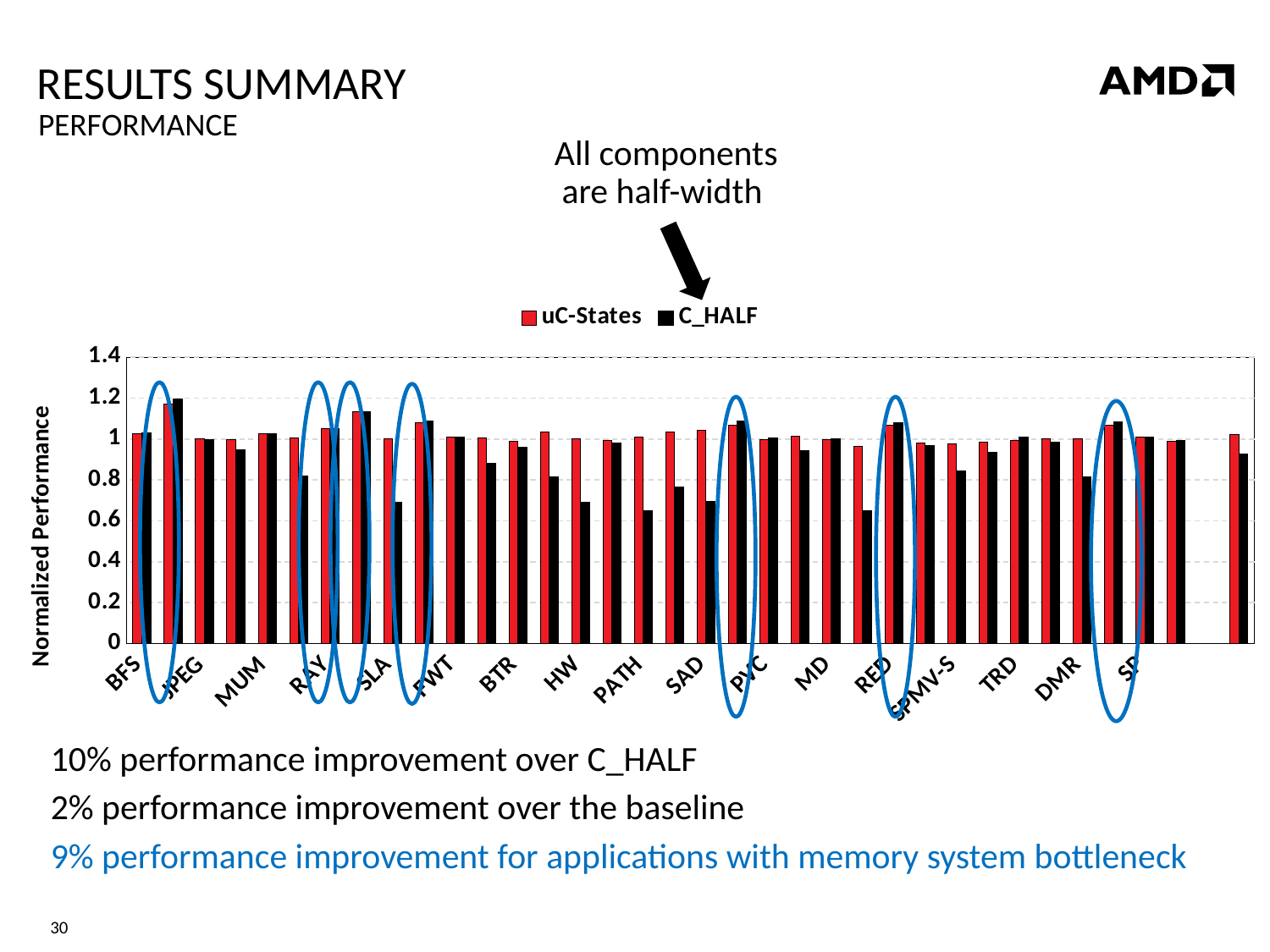
What are the two series named in the chart legend? uC-States and C_HALF How many series does the chart legend list? 2 Is the C_HALF value for SAD greater or less than 0.8? less Which colour represents the C_HALF series in the chart? black What kind of chart is shown on the slide? bar chart Is the uC-States value for BFS greater or less than 0.8? greater What is the highest value shown on the vertical axis of the chart? 1.4 For HW, which series has the larger value, uC-States or C_HALF? uC-States For SAD, which series has the larger value, uC-States or C_HALF? uC-States Is the C_HALF value for HW greater or less than 0.8? less